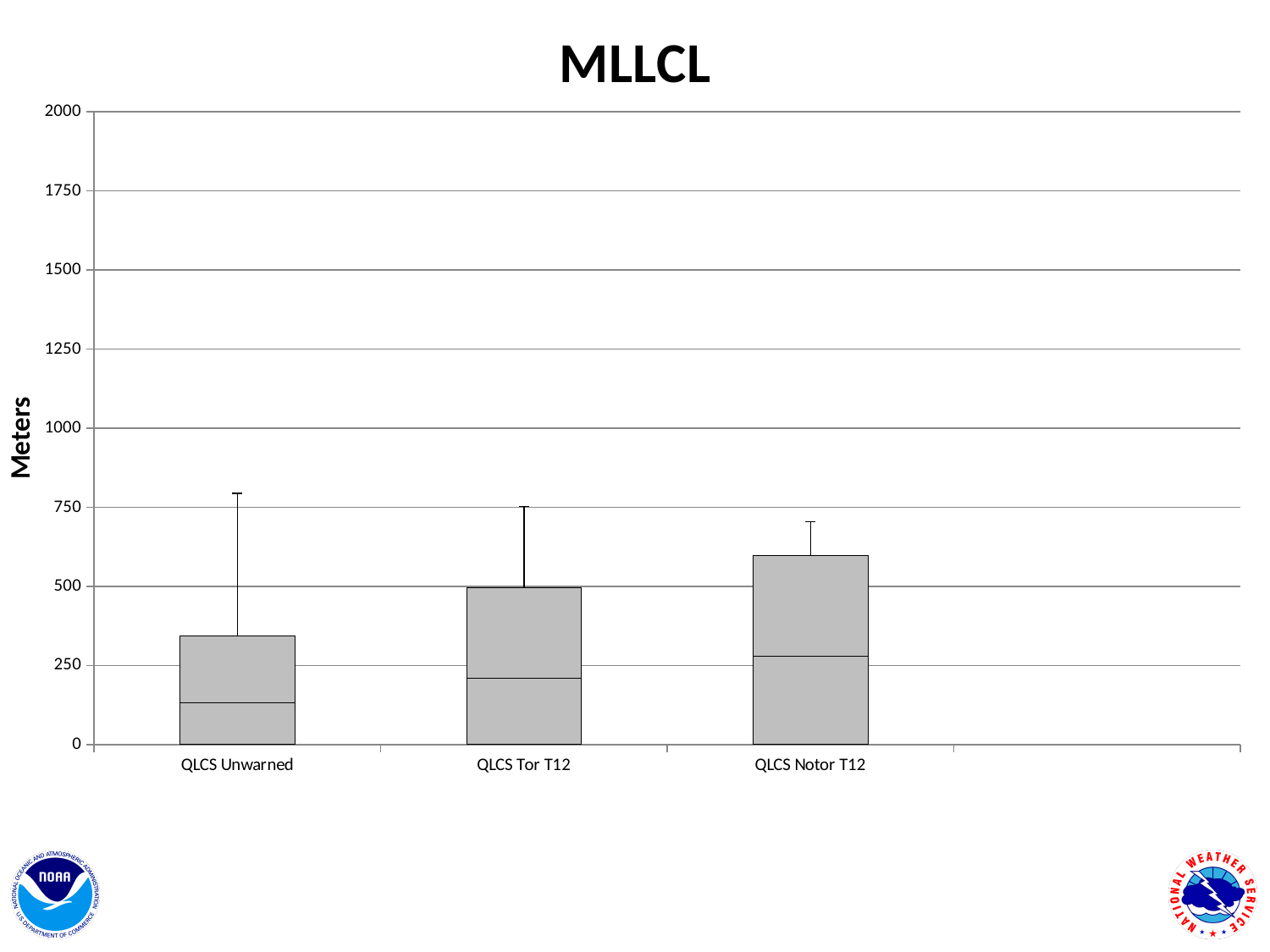
What kind of chart is shown on the slide? bar chart Which category has the tallest bar? QLCS Notor T12 What is the label on the vertical axis of the chart? Meters Which category has the shortest bar? QLCS Unwarned Is the top of the bar for QLCS Unwarned greater or less than 500? less Which bar is taller, QLCS Tor T12 or QLCS Unwarned? QLCS Tor T12 Is the top of the error bar for QLCS Notor T12 greater or less than 750? less How many categories are shown on the x axis of the chart? 3 Is the top of the bar for QLCS Notor T12 greater or less than 500? greater Do the bar heights rise or fall from left to right across the x axis? rise What is the title of the chart? MLLCL